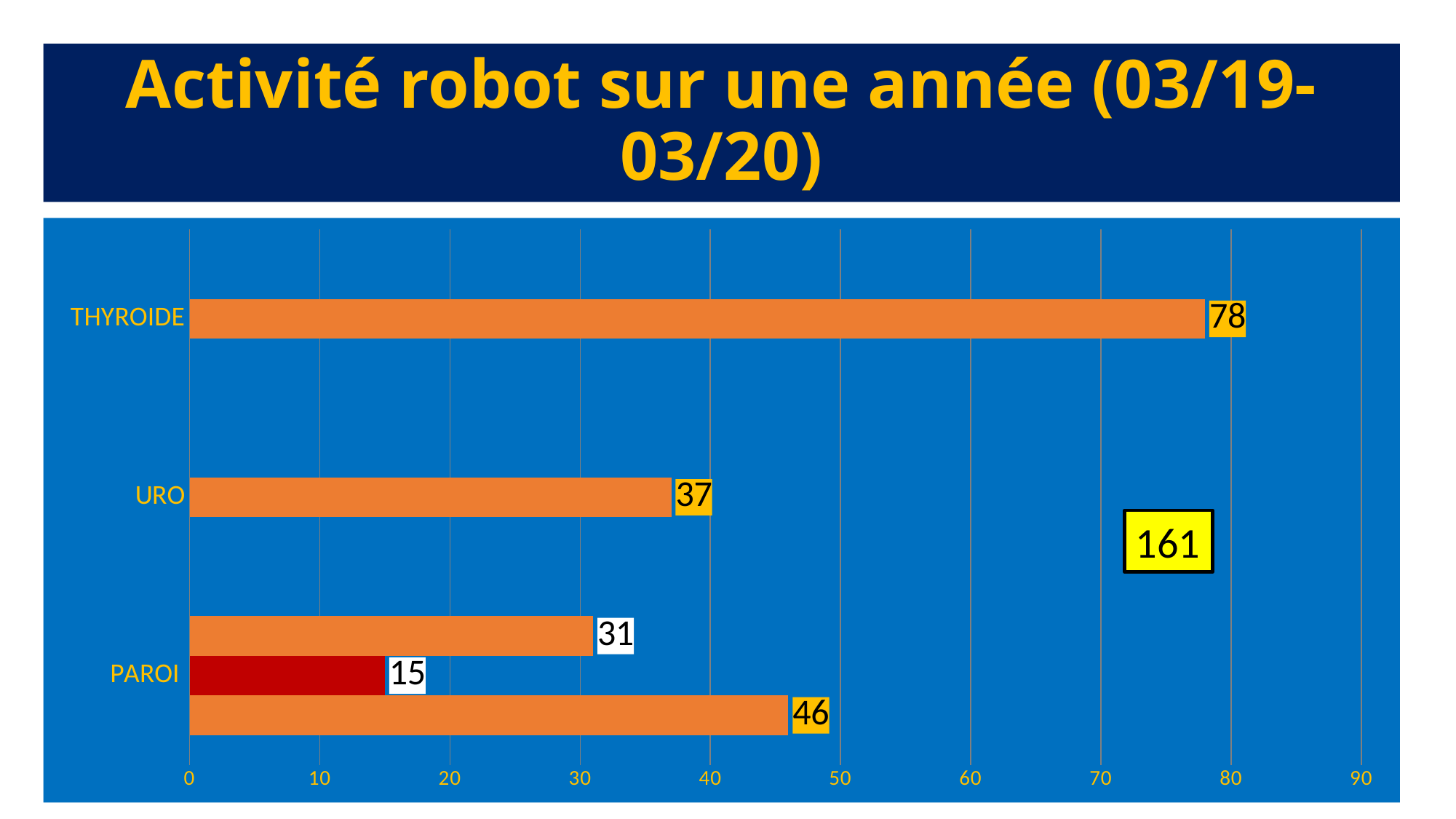
What is the difference between the THYROIDE value and the URO value? 41 What is the value shown for URO? 37 How many categories are listed on the vertical axis? 3 What number is shown in the yellow box on the right side of the chart? 161 What is the value of the top bar in the PAROI group? 31 What value is labelled on the red bar in the PAROI group? 15 What is the value shown for THYROIDE? 78 Which is larger, the URO value or the bottom bar of the PAROI group? The bottom bar of the PAROI group (46) What is the value of the bottom (longest) bar in the PAROI group? 46 What type of chart is shown on the slide? Bar chart Which category has the highest value on the chart? THYROIDE Is the value for THYROIDE greater or less than 70? greater